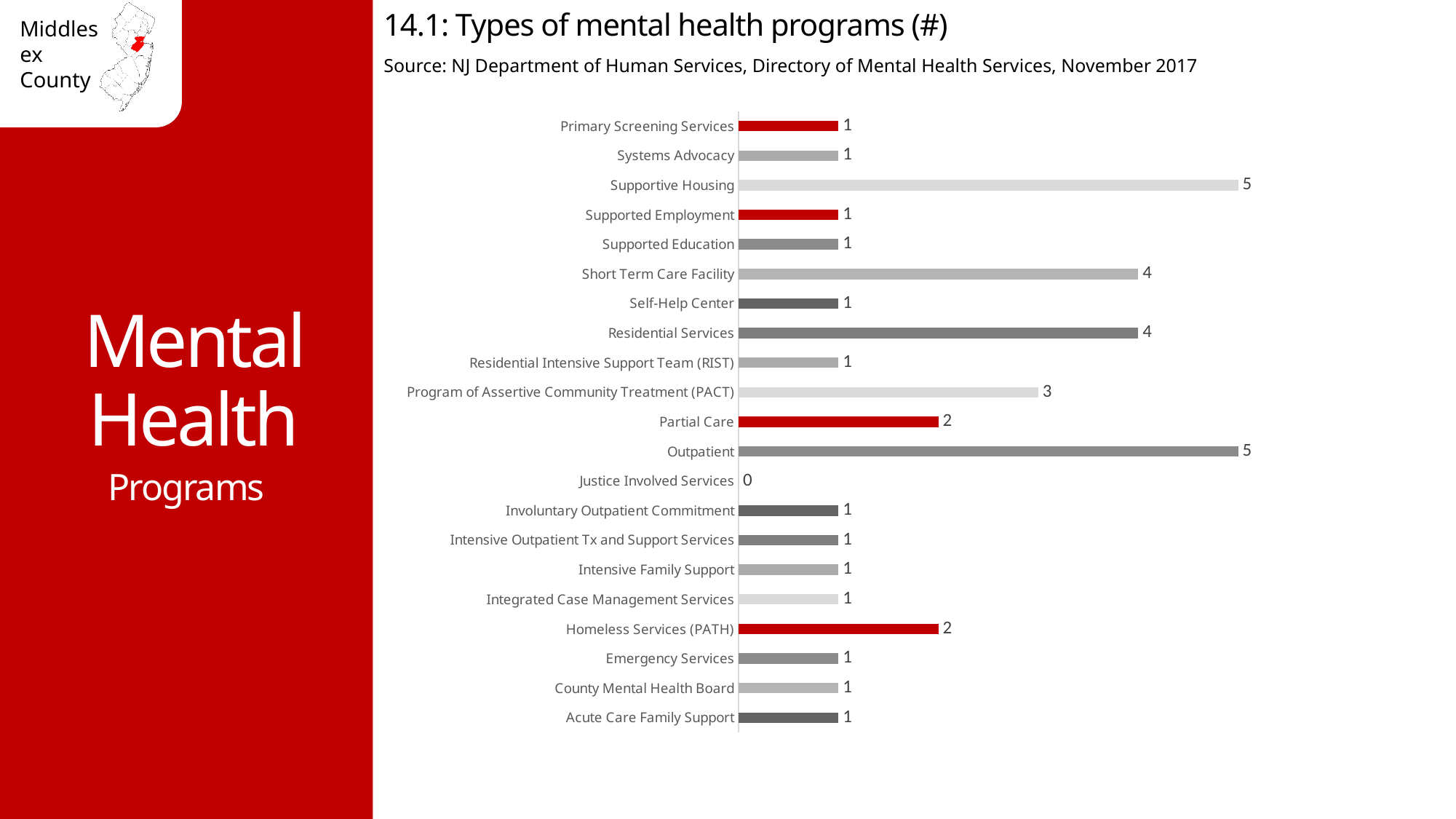
What is the difference between the values for Supportive Housing and Program of Assertive Community Treatment (PACT)? 2 Which category has the lowest value? Justice Involved Services What is the value for Supportive Housing? 5 What is the title of the chart? 14.1: Types of mental health programs (#) Which is larger, the value for Residential Services or the value for Partial Care? Residential Services What is the value for Short Term Care Facility? 4 What is the difference between the values for Outpatient and Residential Services? 1 How many categories are shown in the chart? 21 What is the value for Program of Assertive Community Treatment (PACT)? 3 What kind of chart is shown on the slide? Bar chart What is the value for Homeless Services (PATH)? 2 What is the value for Partial Care? 2